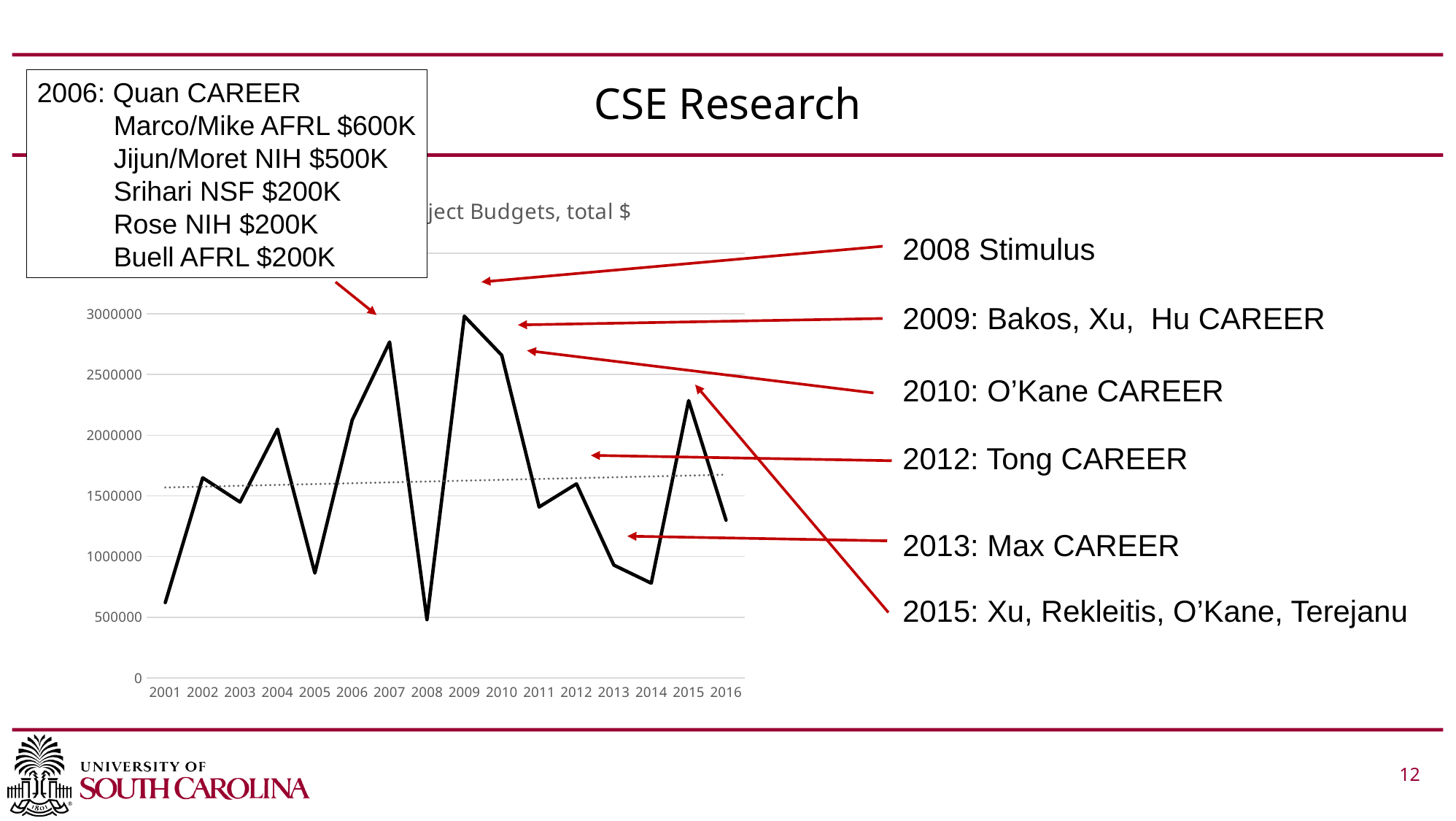
Which year has the lowest value on the chart? 2008 Does the value rise or fall from 2009 to 2011? fall What kind of chart is shown on the slide? line chart Is the value for 2015 greater or less than 2000000? greater Which year has the highest value on the chart? 2009 Which year has the larger value, 2004 or 2005? 2004 How many years are plotted along the x axis of the chart? 16 Is the value for 2005 greater or less than 1000000? less Is the value for 2007 greater or less than 2500000? greater Which year has the larger value, 2010 or 2011? 2010 Which year on the chart is annotated with the label "Stimulus"? 2008